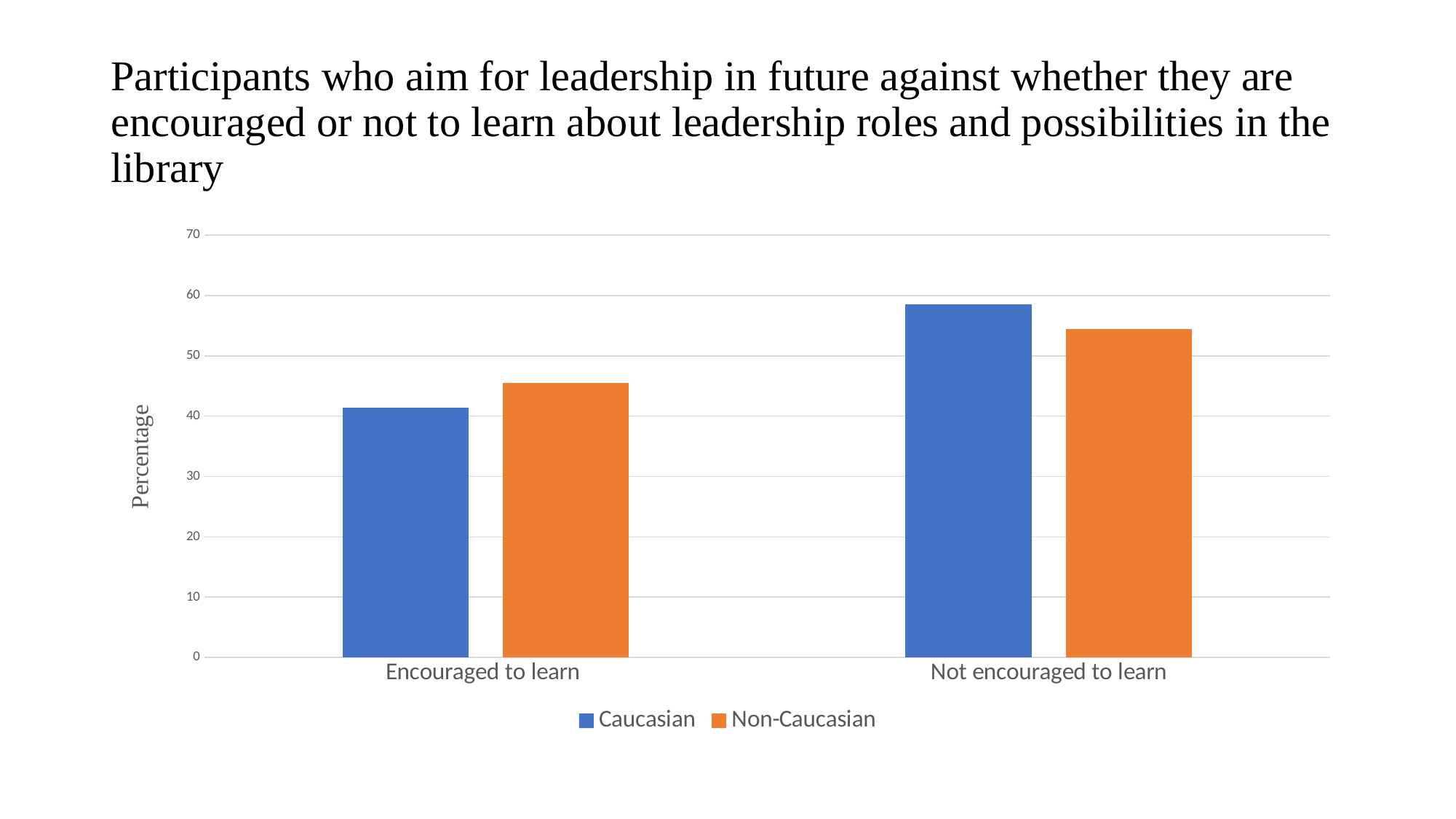
Does the Caucasian series rise or fall from 'Encouraged to learn' to 'Not encouraged to learn'? rise Which series and category has the lowest bar? Caucasian, Encouraged to learn What kind of chart is shown on the slide? bar chart How many categories are shown on the x axis? 2 What is the label on the vertical axis? Percentage Is the Caucasian value for 'Encouraged to learn' greater or less than 50? less Is the Non-Caucasian value for 'Not encouraged to learn' greater or less than 50? greater Is the Caucasian value for 'Not encouraged to learn' greater or less than 60? less For 'Encouraged to learn', which is larger: Caucasian or Non-Caucasian? Non-Caucasian Which series and category has the highest bar? Caucasian, Not encouraged to learn For 'Not encouraged to learn', which is larger: Caucasian or Non-Caucasian? Caucasian How many series does the legend list? 2